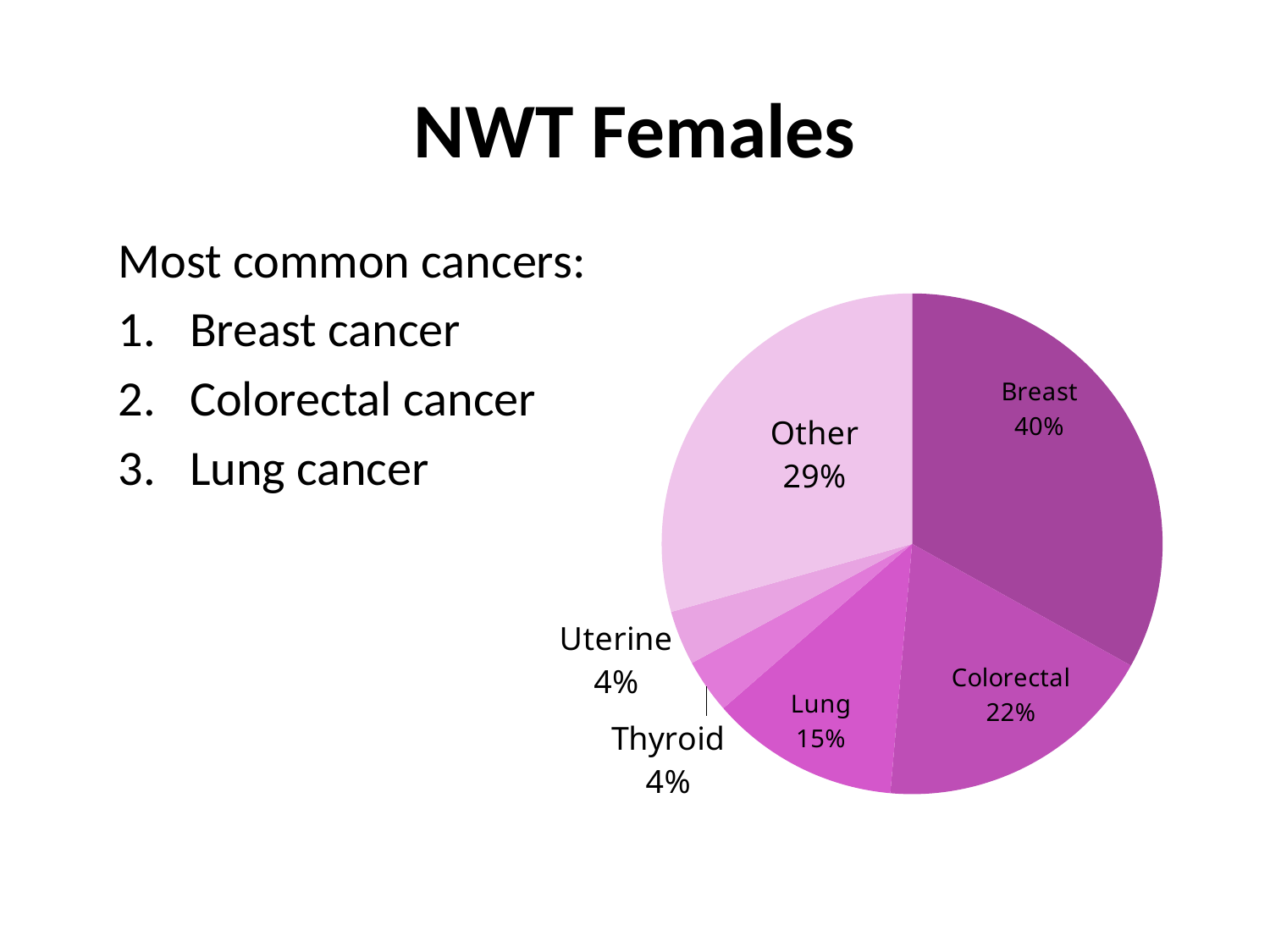
Which slice is larger, Colorectal or Other? Other How many slices does the pie chart have? 6 What share of the pie does Lung represent? 15% What share of the pie does Other represent? 29% What kind of chart is shown on the slide? Pie chart What is the difference in percentage points between the Other and Lung slices? 14 What is the title of the slide containing the chart? NWT Females What share of the pie does Breast represent? 40% What share of the pie does Thyroid represent? 4% What is the difference in percentage points between the Breast and Colorectal slices? 18 Which slice of the pie is the largest? Breast What share of the pie does Colorectal represent? 22%